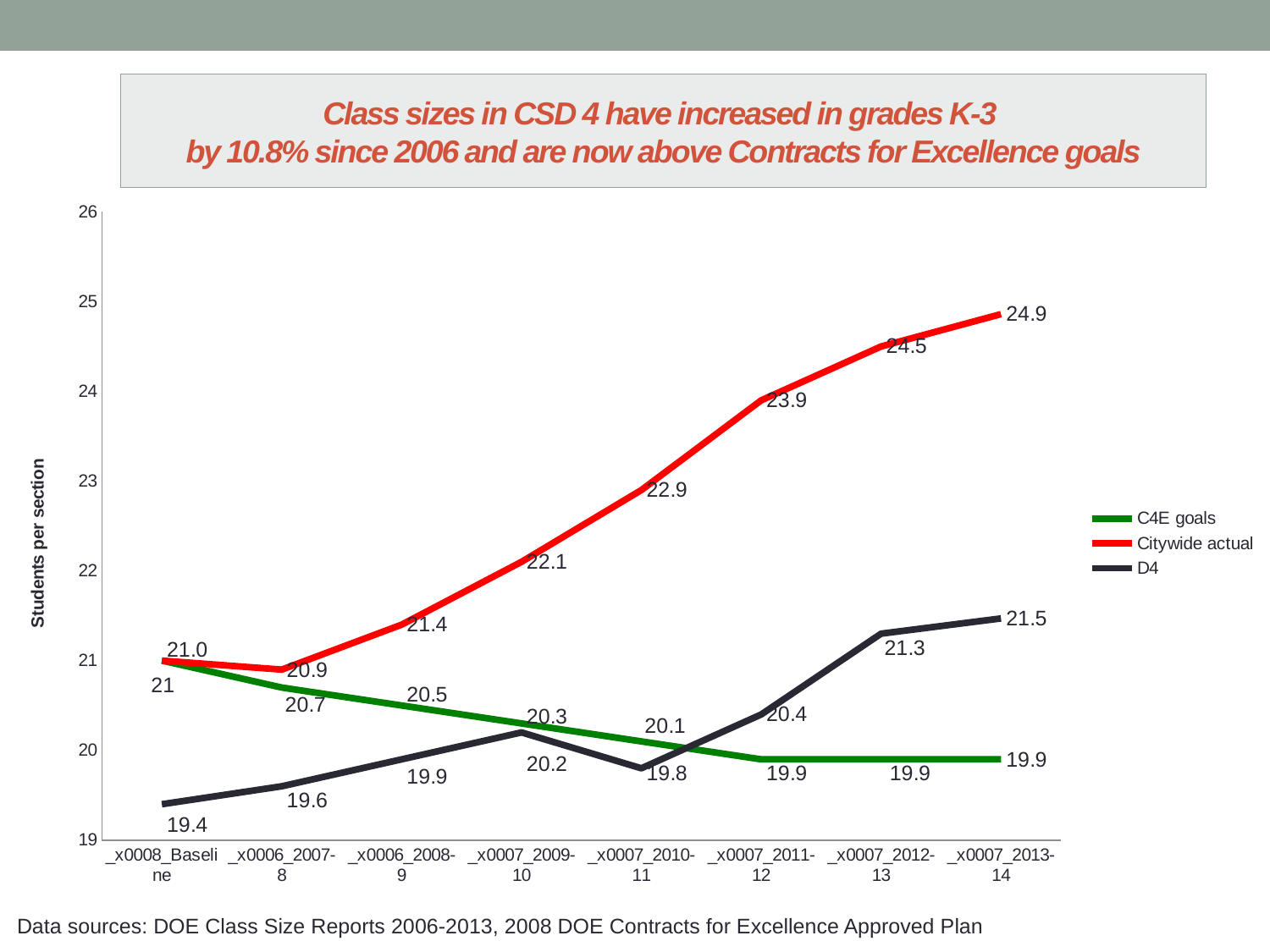
At which point is the D4 series lowest? Baseline Which is larger in 2010-11, the C4E goals value or the D4 value? C4E goals What is the difference between the Citywide actual value and the D4 value in 2013-14? 3.4 How many series does the legend list? 3 What kind of chart is shown on the slide? Line chart What is the D4 value for 2012-13? 21.3 What is the Citywide actual value for 2013-14? 24.9 In which year does the Citywide actual series reach its highest value? 2013-14 What is the label on the vertical axis? Students per section What is the D4 value at the Baseline point? 19.4 Does the C4E goals series rise or fall from Baseline to 2013-14? Fall What is the C4E goals value for 2009-10? 20.3